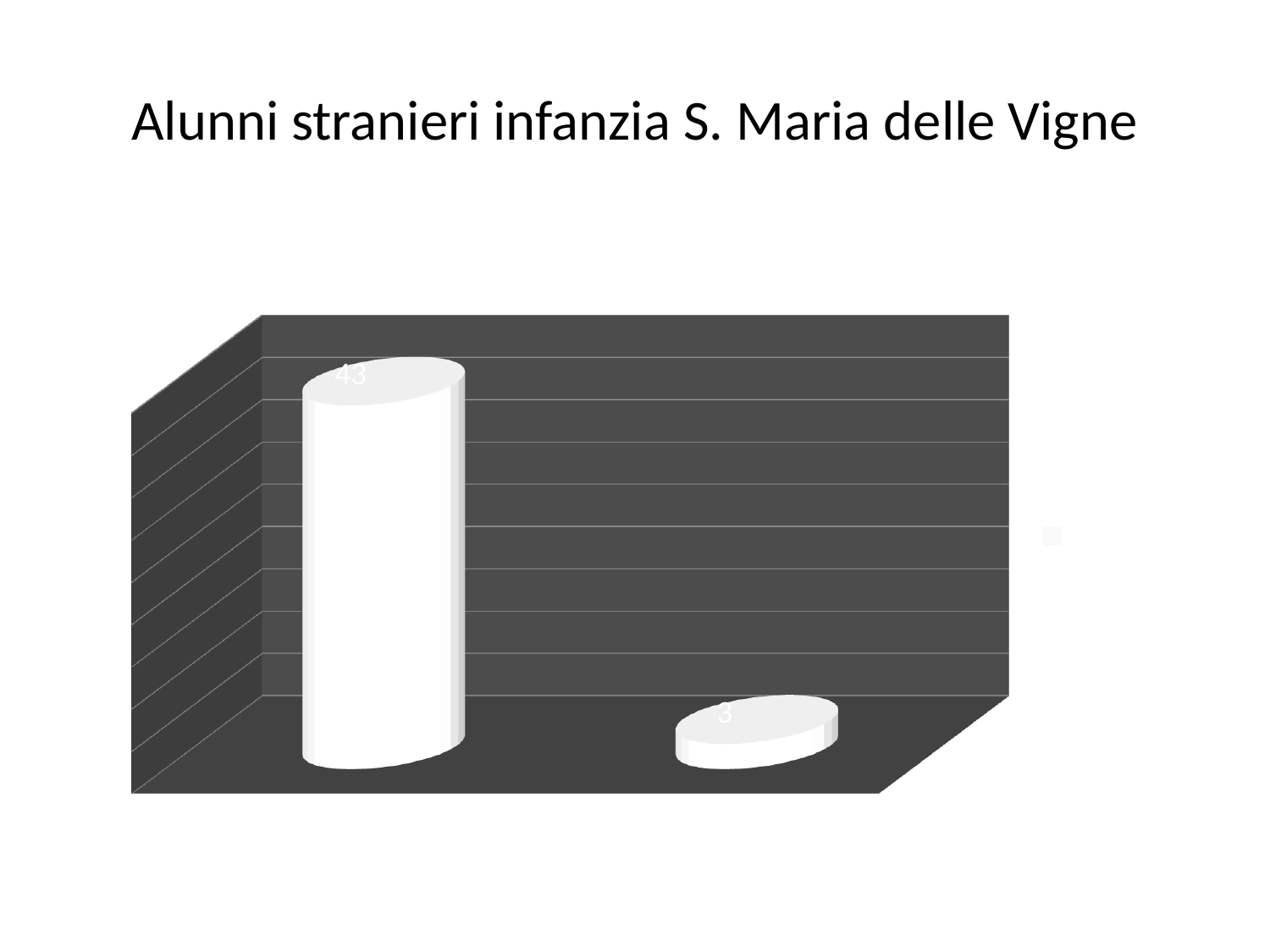
What is the difference between the values of the left bar and the right bar? 40 What is the value shown on the right bar of the chart? 3 What is the value shown on the left bar of the chart? 43 Which bar has the larger value, the left one or the right one? the left one Do the values rise or fall from the left bar to the right bar? fall What is the highest value shown in the chart? 43 What kind of chart is shown on the slide? bar chart What is the title of the chart on the slide? Alunni stranieri infanzia S. Maria delle Vigne What colour are the bars in the chart? white What is the lowest value shown in the chart? 3 How many bars are plotted in the chart? 2